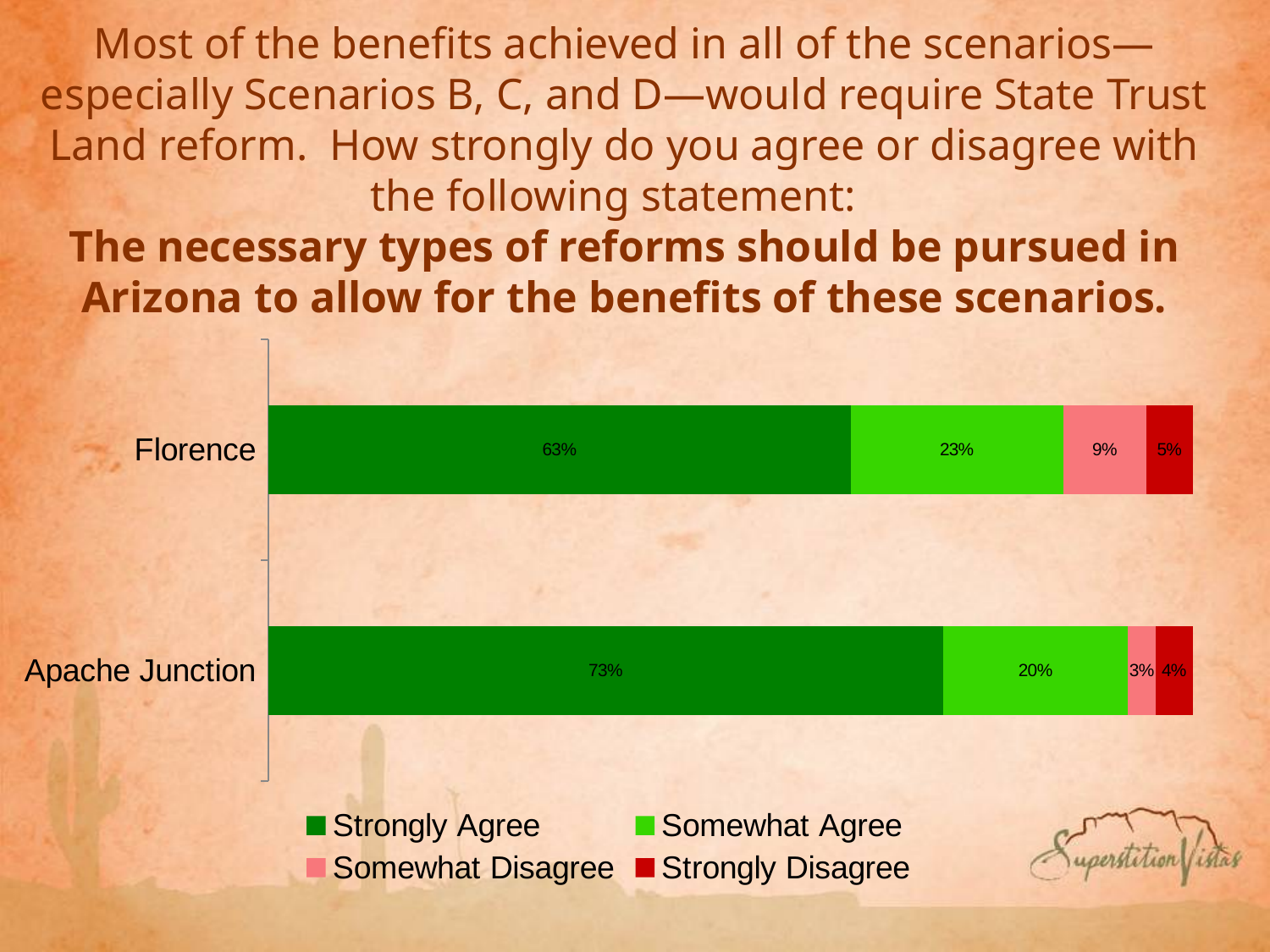
What is the difference between the Somewhat Disagree percentages for Florence and Apache Junction? 6% What kind of chart is shown on the slide? Stacked bar chart What is the total of the Strongly Agree and Somewhat Agree segments for Florence? 86% What percentage of Apache Junction respondents Strongly Agree? 73% What percentage of Apache Junction respondents Somewhat Agree? 20% What percentage of Apache Junction respondents Strongly Disagree? 4% What percentage of Florence respondents Strongly Agree? 63% What is the difference between the Strongly Agree percentages for Apache Junction and Florence? 10% What percentage of Florence respondents Somewhat Disagree? 9% Which location has the higher Strongly Agree percentage? Apache Junction How many locations are shown in the chart? 2 How many series does the legend list? 4